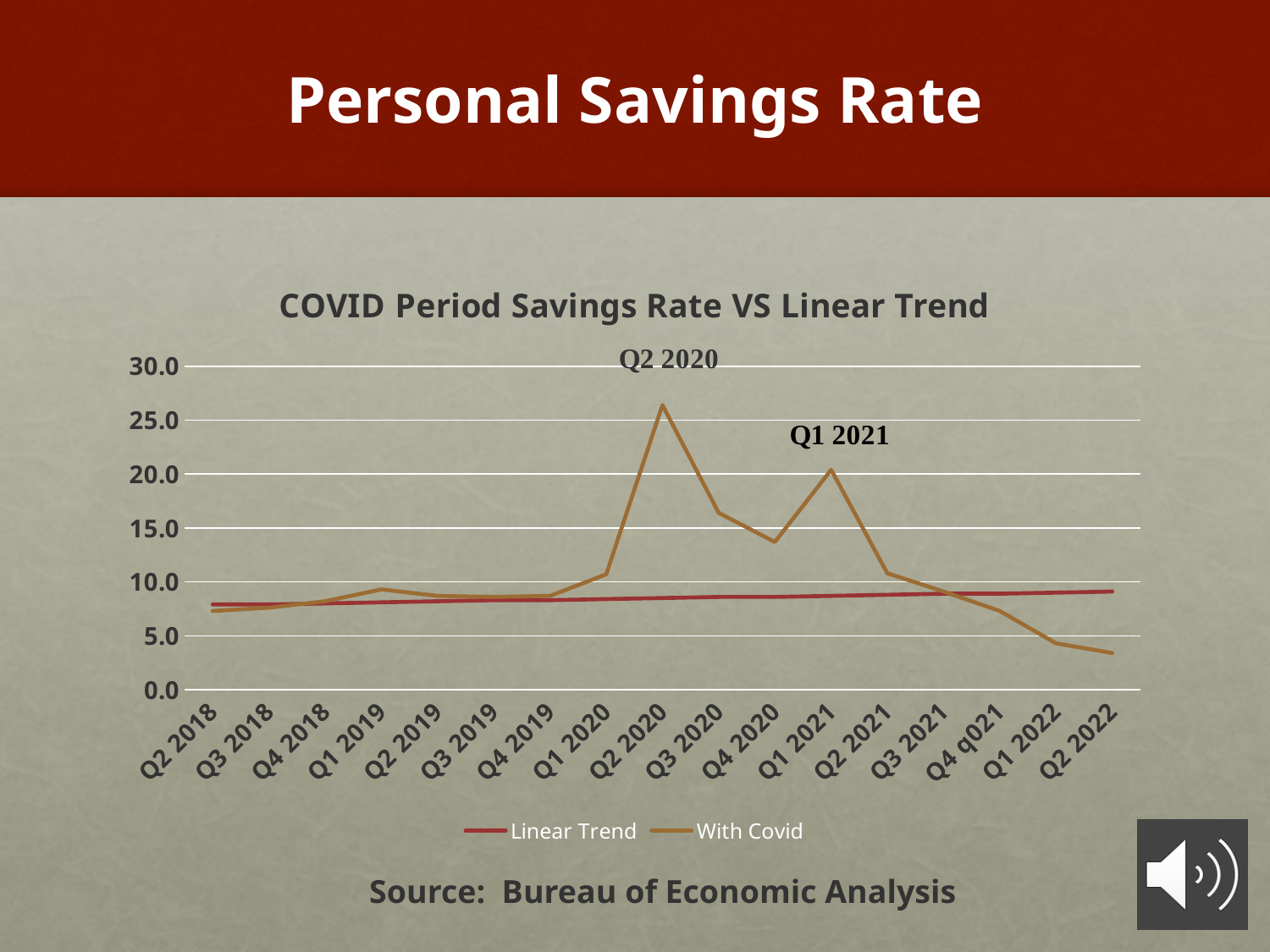
Is the Linear Trend value for Q2 2022 greater or less than 10.0? less Is the With Covid value for Q2 2020 greater or less than 20.0? greater Which is larger for the With Covid series: the value at Q2 2020 or the value at Q1 2021? Q2 2020 What is the title of the chart? COVID Period Savings Rate VS Linear Trend In which quarter does the With Covid series reach its highest value? Q2 2020 Is the With Covid value for Q1 2021 greater or less than 15.0? greater How many quarters are plotted along the x axis? 17 What kind of chart is shown on the slide? line chart In which quarter does the With Covid series reach its lowest value? Q2 2022 How many series does the legend list? 2 Does the Linear Trend series rise or fall from Q2 2018 to Q2 2022? rises